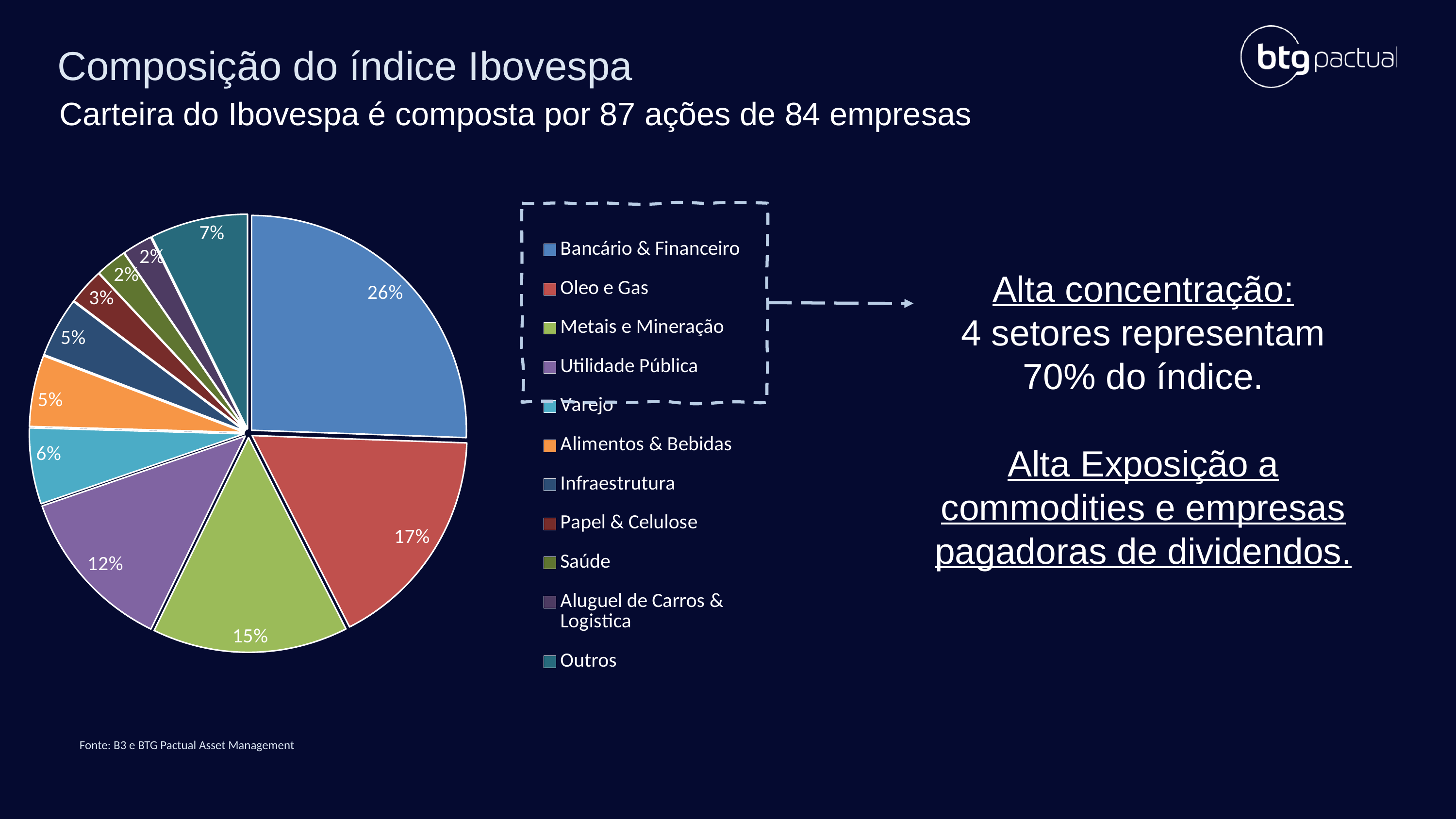
What share does Outros represent in the pie chart? 7% What is the combined share of the four largest sectors (Bancário & Financeiro, Oleo e Gas, Metais e Mineração, Utilidade Pública)? 70% What percentage is shown for Metais e Mineração? 15% What is the title of the slide containing the pie chart? Composição do índice Ibovespa What is the difference between the Bancário & Financeiro share and the Oleo e Gas share? 9% What is the value shown for Oleo e Gas? 17% What is the value for Utilidade Pública? 12% How many sectors are listed in the legend of the pie chart? 11 What kind of chart is shown on the slide? pie chart What share of the Ibovespa index does Bancário & Financeiro represent? 26% Which sector has the largest slice of the pie chart? Bancário & Financeiro Which is larger, the share for Utilidade Pública or the share for Varejo? Utilidade Pública